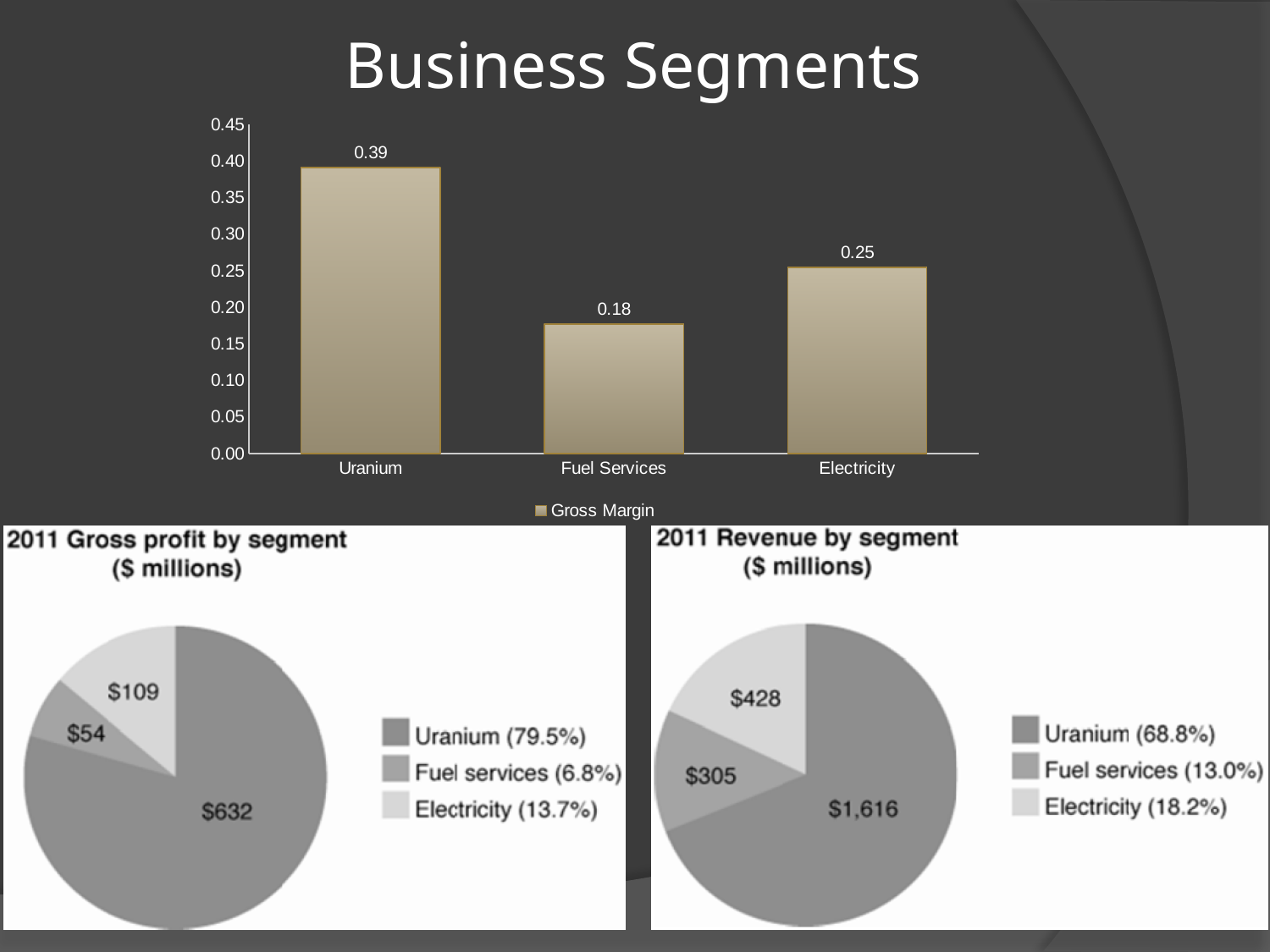
In the Gross Margin bar chart at the top of the slide, how many categories are shown? 3 In the Gross Margin bar chart at the top of the slide, which category has the lowest value? Fuel Services What is the title of the pie chart on the right side of the slide? 2011 Revenue by segment ($ millions) In the '2011 Gross profit by segment' pie chart, what is the value for Uranium? $632 In the '2011 Revenue by segment' pie chart, which segment has the largest share? Uranium In the Gross Margin bar chart at the top of the slide, what is the difference between the Uranium and Electricity values? 0.14 In the '2011 Gross profit by segment' pie chart, what share does Electricity have? 13.7% In the Gross Margin bar chart at the top of the slide, what is the value for Fuel Services? 0.18 In the '2011 Revenue by segment' pie chart, what is the value for Fuel services? $305 In the '2011 Revenue by segment' pie chart, is the Electricity value larger or smaller than the Fuel services value? Larger What kind of chart is the Gross Margin chart at the top of the slide? Bar chart In the Gross Margin bar chart at the top of the slide, what is the value for Uranium? 0.39